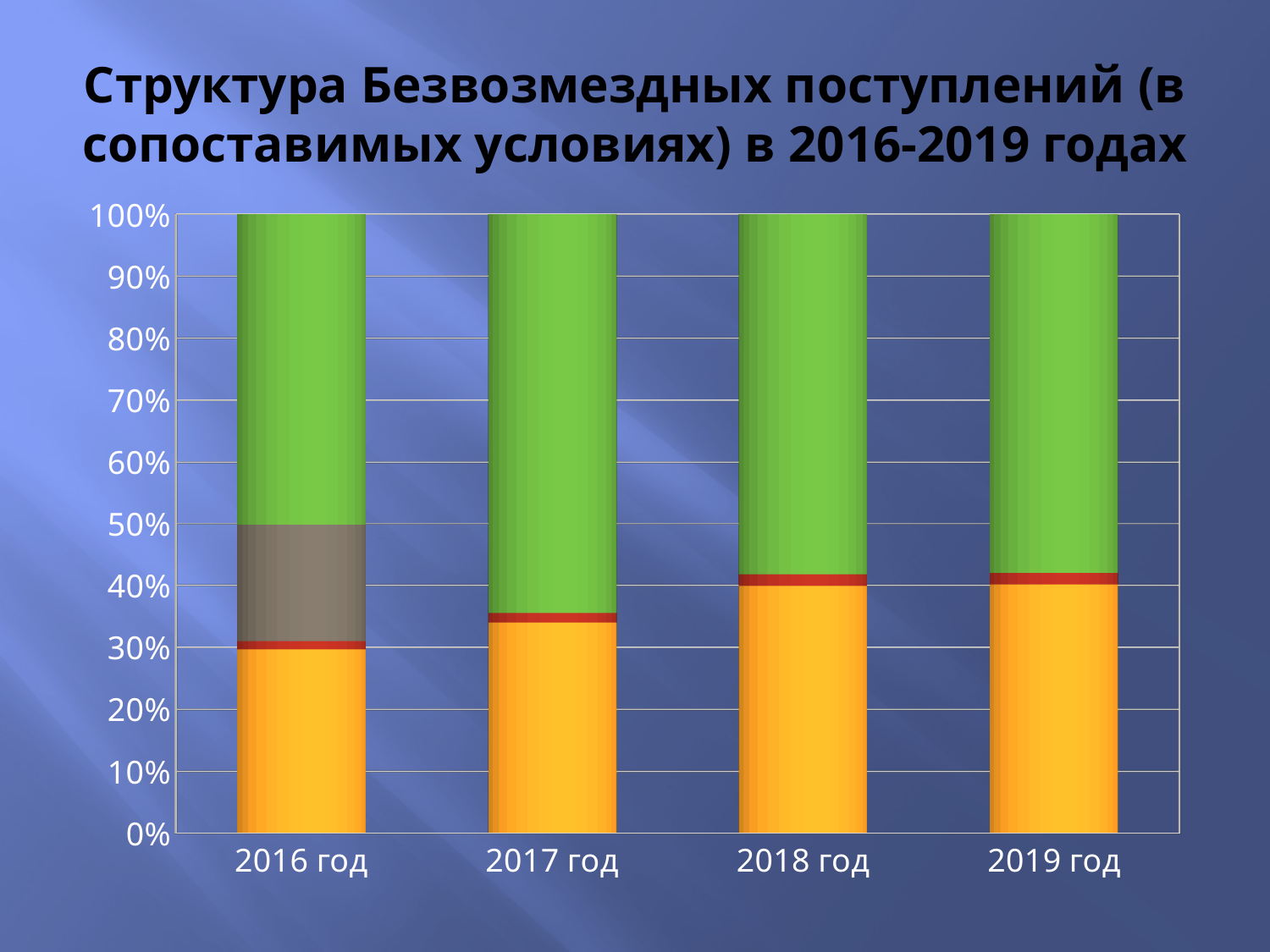
Which year has the smallest orange (bottom) segment? 2016 год Is the orange (bottom) segment for 2016 год greater or less than 40%? less Is the orange (bottom) segment for 2017 год greater or less than 30%? greater What is the total height of the stacked bar for 2016 год? 100% Which year is the only one whose bar contains a grey segment? 2016 год What is the highest value shown on the y axis of the chart? 100% What kind of chart is shown on the slide? stacked bar chart Is the orange (bottom) segment for 2019 год greater or less than 50%? less Which is larger, the orange (bottom) segment for 2016 год or for 2019 год? 2019 год Does the orange (bottom) segment rise or fall from 2016 год to 2019 год? rise How many years (categories) are shown on the x axis of the chart? 4